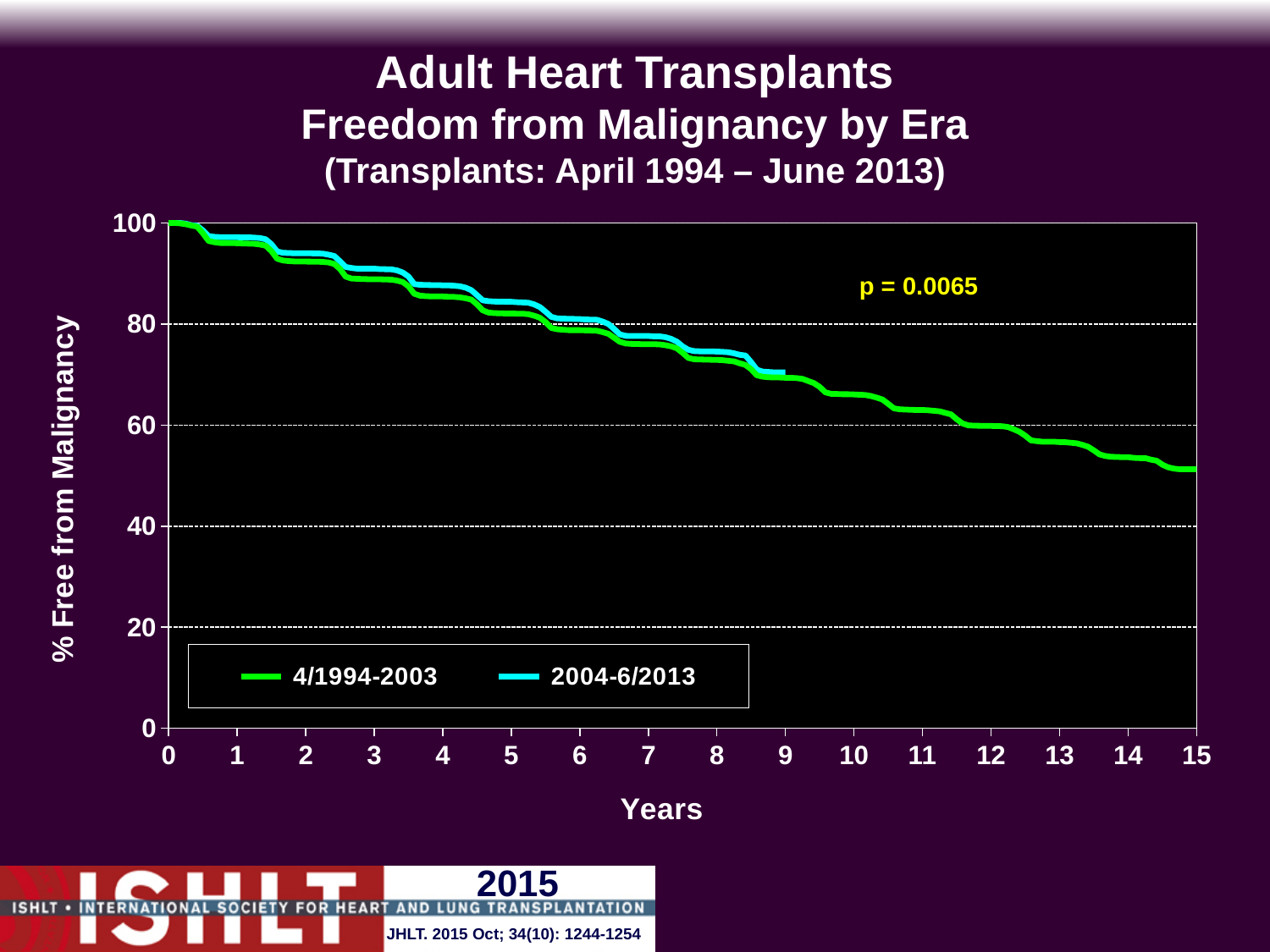
What is the label of the y axis? % Free from Malignancy Is the value for the 4/1994-2003 series at 7 years greater or less than 80? less Is the value for the 4/1994-2003 series at 10 years greater or less than 60? greater What p-value is printed on the chart? p = 0.0065 Do the values for the 4/1994-2003 series rise or fall as years increase? fall How many series does the legend list? 2 Is the value for the 4/1994-2003 series at 15 years greater or less than 60? less What kind of chart is shown on the slide? line chart Which series extends further along the x axis, 4/1994-2003 or 2004-6/2013? 4/1994-2003